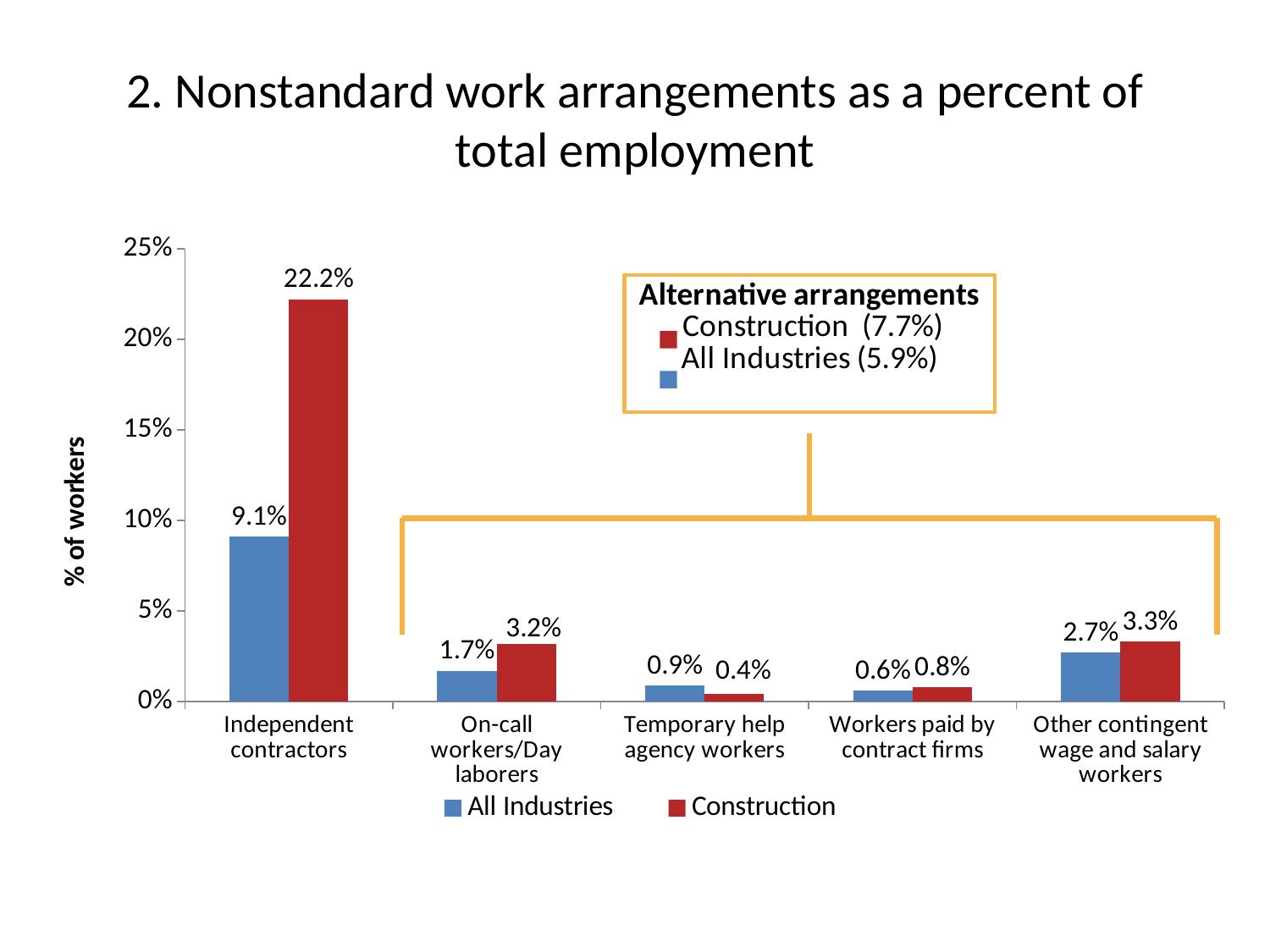
Which category has the highest Construction value? Independent contractors How many series does the legend list? 2 What is the Construction value for On-call workers/Day laborers? 3.2% What is the label of the y axis? % of workers What is the difference between the Construction and All Industries values for Independent contractors? 13.1% What kind of chart is shown on the slide? Bar chart For Temporary help agency workers, which series has the larger value, All Industries or Construction? All Industries What is the All Industries value for Temporary help agency workers? 0.9% What is the Construction value for Independent contractors? 22.2% How many categories are shown on the x axis? 5 Which category has the lowest All Industries value? Workers paid by contract firms What is the All Industries value for Independent contractors? 9.1%